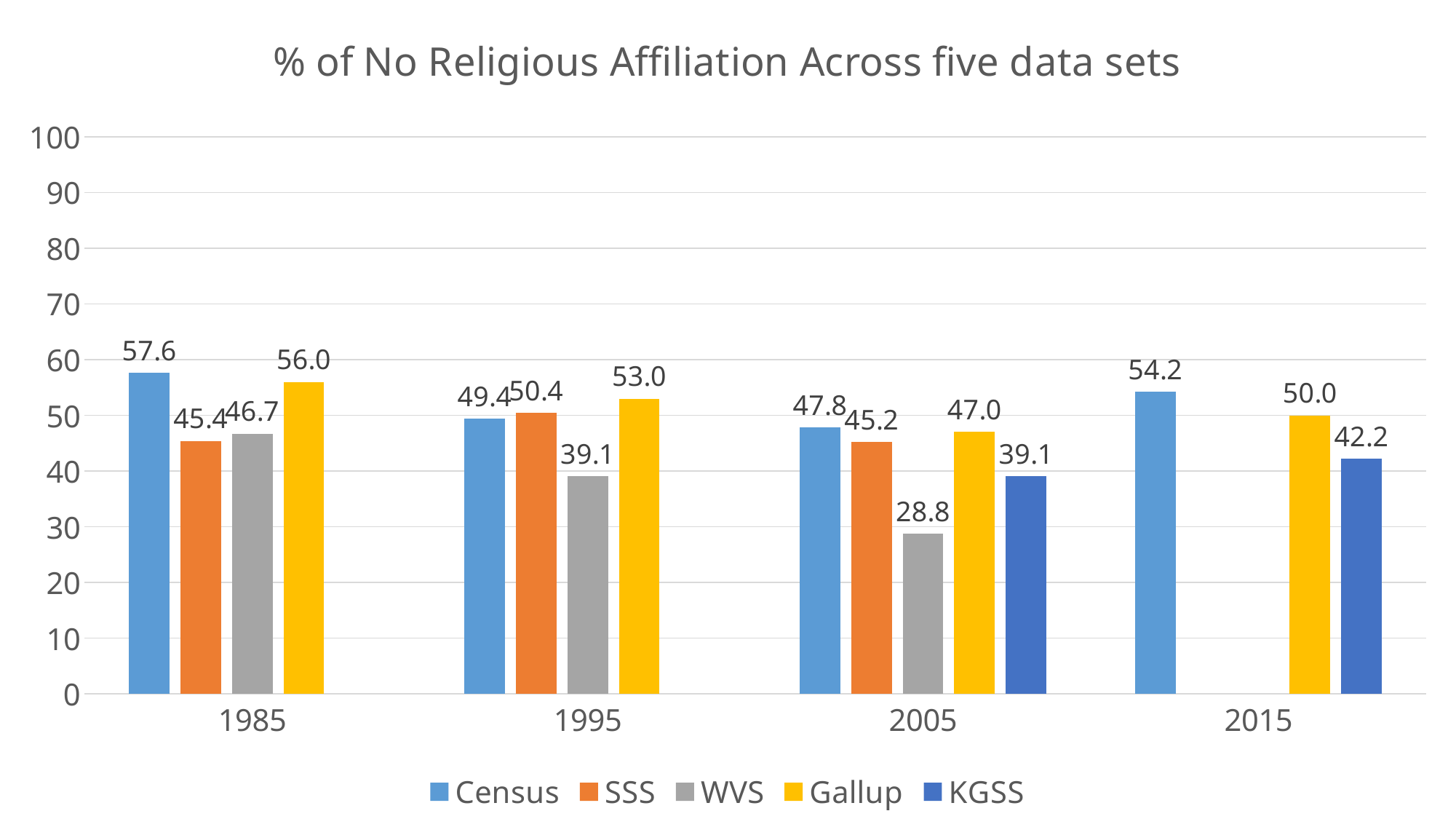
What is the KGSS value for 2015? 42.2 Which data set has the lowest value in 2005? WVS Does the WVS value rise or fall from 1985 to 2005? Fall How many years are shown on the x axis? 4 What is the Census value for 1985? 57.6 What kind of chart is shown on the slide? Bar chart What is the WVS value for 2005? 28.8 What is the difference between the Census and SSS values in 1985? 12.2 How many series does the legend list? 5 What is the Gallup value for 1995? 53.0 Which year has the highest Census value? 1985 Which is larger in 1995, the SSS value or the Census value? SSS